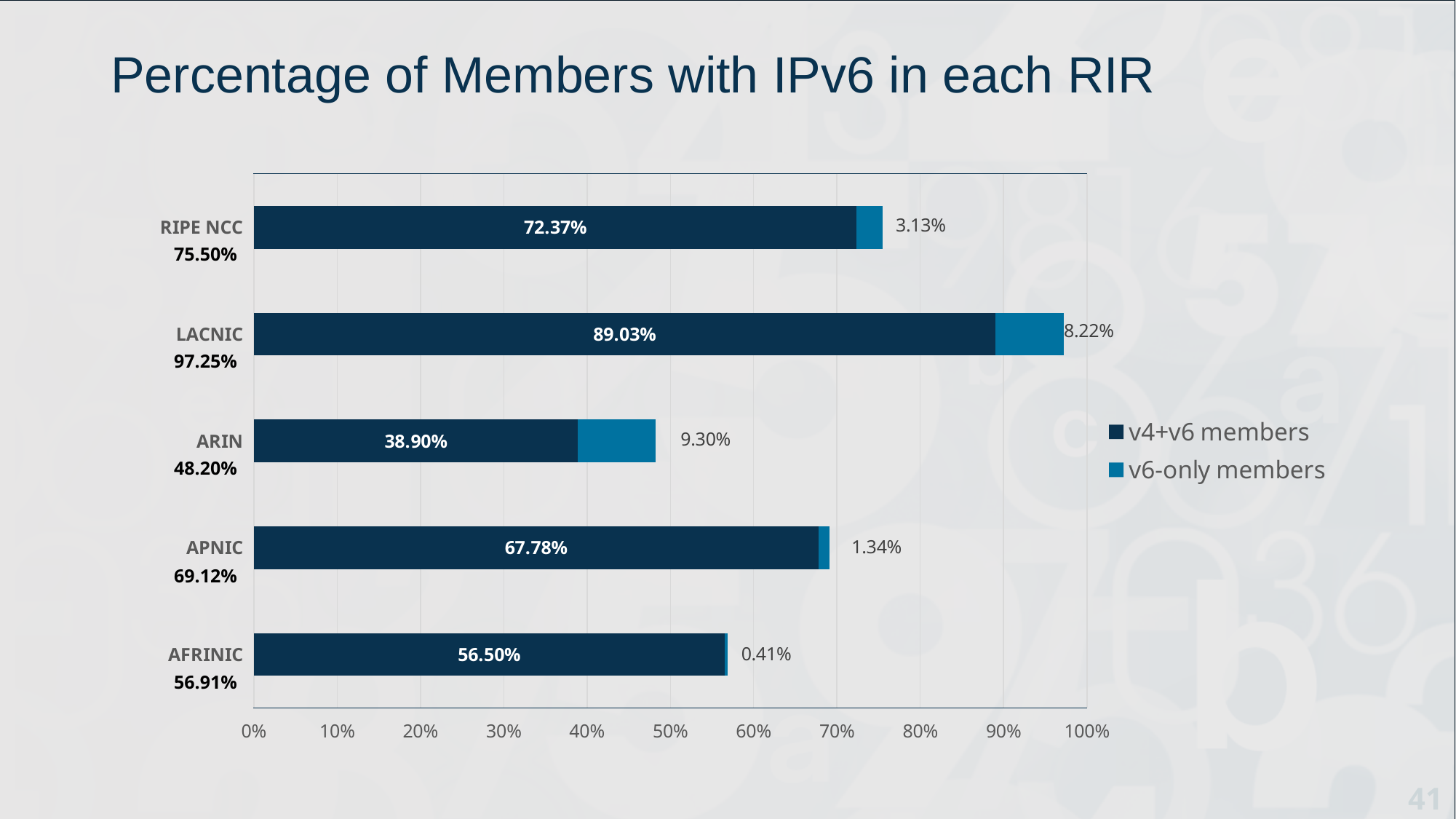
What is the title of the chart? Percentage of Members with IPv6 in each RIR How many series does the legend list? 2 What is the v4+v6 members value for LACNIC? 89.03% What is the v6-only members value for ARIN? 9.30% Which is larger, the v6-only members value for RIPE NCC or for APNIC? RIPE NCC Which RIR has the highest v4+v6 members percentage? LACNIC What is the difference between the v4+v6 members values for RIPE NCC and APNIC? 4.59% Which RIR has the lowest v6-only members percentage? AFRINIC What kind of chart is shown on the slide? Stacked bar chart How many RIRs are shown on the chart? 5 What is the total percentage of members with IPv6 for ARIN? 48.20% What is the v6-only members value for AFRINIC? 0.41%